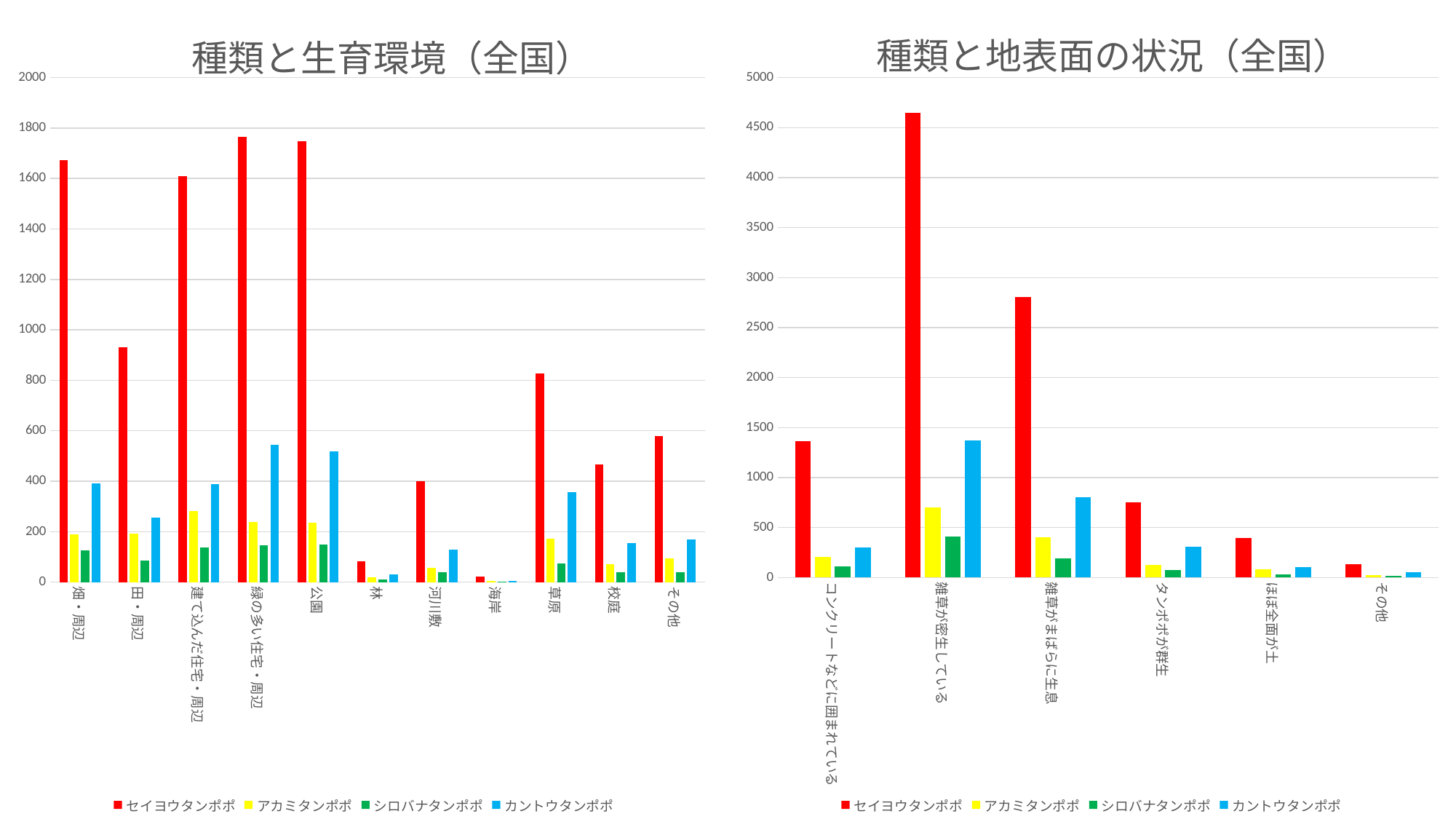
What kind of chart is the 種類と生育環境（全国） chart on the left? bar chart How many series does the legend of the 種類と地表面の状況（全国） chart list? 4 In the 種類と生育環境（全国） chart, which category has the lowest value for セイヨウタンポポ? 海岸 In the 種類と地表面の状況（全国） chart, is the value for セイヨウタンポポ at 雑草がまばらに生息 greater or less than 2500? greater In the 種類と生育環境（全国） chart, which is larger for セイヨウタンポポ: 草原 or 校庭? 草原 In the 種類と地表面の状況（全国） chart, which series is shown in blue? カントウタンポポ In the 種類と地表面の状況（全国） chart, which category has the lowest value for セイヨウタンポポ? その他 In the 種類と地表面の状況（全国） chart, which category has the highest value for セイヨウタンポポ? 雑草が密生している In the 種類と生育環境（全国） chart, is the value for セイヨウタンポポ at 畑・周辺 greater or less than 1600? greater In the 種類と生育環境（全国） chart, is the value for セイヨウタンポポ at 田・周辺 greater or less than 1000? less How many categories are shown on the x axis of the 種類と地表面の状況（全国） chart? 6 How many categories are shown on the x axis of the 種類と生育環境（全国） chart? 11